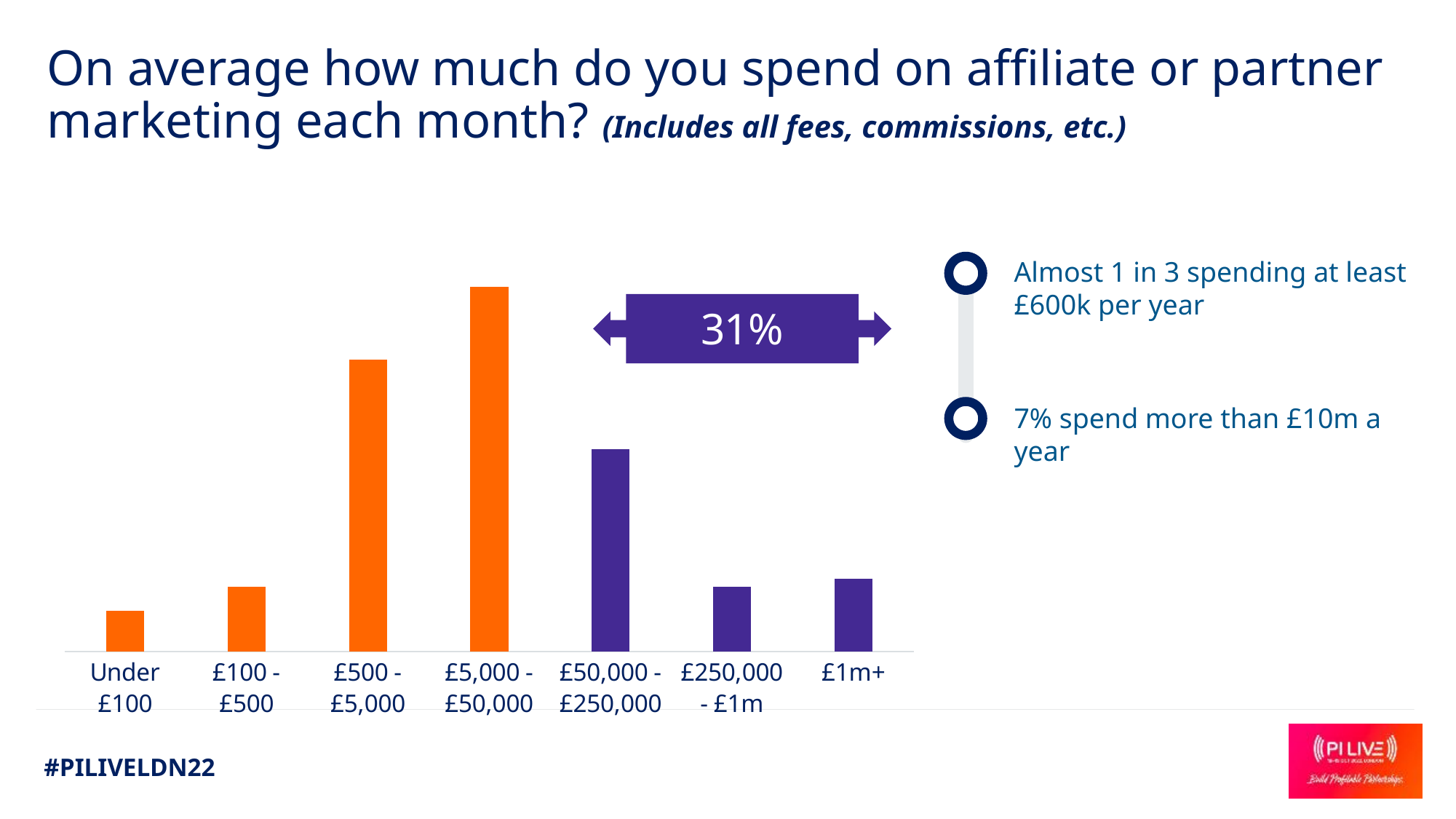
What percentage is shown in the purple arrow label above the purple bars? 31% Which spending category has the shortest bar? Under £100 Which bar is taller: £5,000 - £50,000 or £500 - £5,000? £5,000 - £50,000 Which is the second-tallest bar in the chart? £500 - £5,000 Which bar is taller: £50,000 - £250,000 or £250,000 - £1m? £50,000 - £250,000 Which bar is taller: Under £100 or £100 - £500? £100 - £500 Which spending category has the tallest bar? £5,000 - £50,000 How many spending categories are shown on the x axis of the chart? 7 How many bars in the chart are coloured purple? 3 What kind of chart is shown on the slide? bar chart